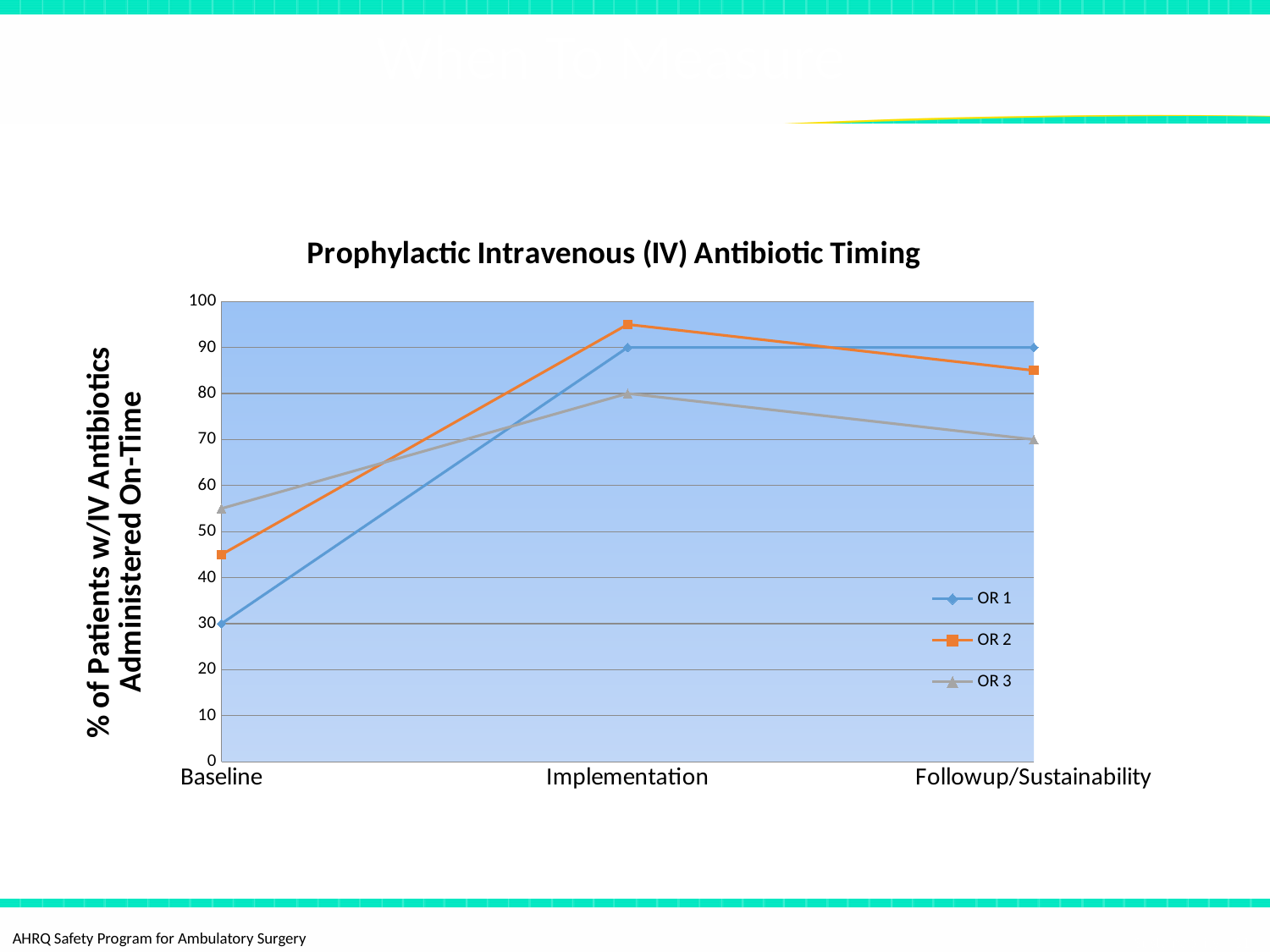
How many categories are shown on the x axis? 3 Which series has the highest value at Implementation? OR 2 What is the difference between the OR 1 value at Implementation and at Baseline? 60 What is the value for OR 3 at Followup/Sustainability? 70 What is the value for OR 1 at Baseline? 30 Does the OR 3 line rise or fall from Implementation to Followup/Sustainability? fall Is the value for OR 2 at Baseline greater or less than 40? greater What kind of chart is shown on the slide? line chart Which series has the lowest value at Baseline? OR 1 Which is larger at Followup/Sustainability, OR 1 or OR 3? OR 1 How many series does the legend list? 3 What is the value for OR 1 at Implementation? 90